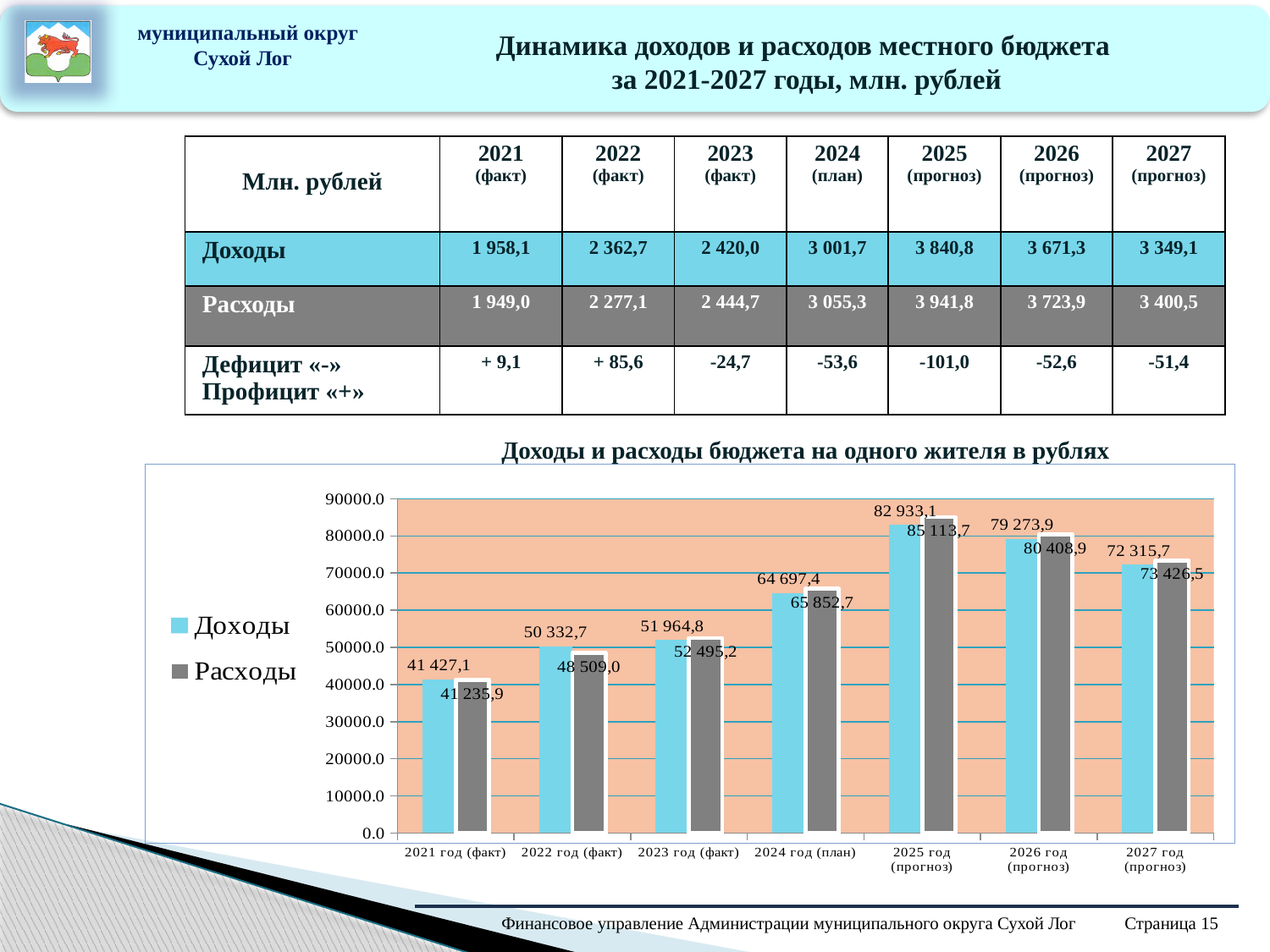
How many series does the legend of the chart list? 2 Is the Доходы value for 2023 год (факт) greater or less than 60000.0? less What is the difference between Расходы and Доходы for 2025 год (прогноз) in the chart? 2 180,6 In which year is the Доходы value lowest in the chart? 2021 год (факт) What is the value of Доходы for 2021 год (факт) in the chart? 41 427,1 How many year categories are shown on the x axis of the chart? 7 What is the value of Расходы for 2024 год (план) in the chart? 65 852,7 What is the value of Доходы for 2027 год (прогноз) in the chart? 72 315,7 Do the Доходы values rise or fall from 2021 год (факт) to 2025 год (прогноз) in the chart? rise In which year is the Расходы value highest in the chart? 2025 год (прогноз) What type of chart is shown under the title "Доходы и расходы бюджета на одного жителя в рублях"? bar chart Which is larger in the chart for 2022 год (факт): Доходы or Расходы? Доходы